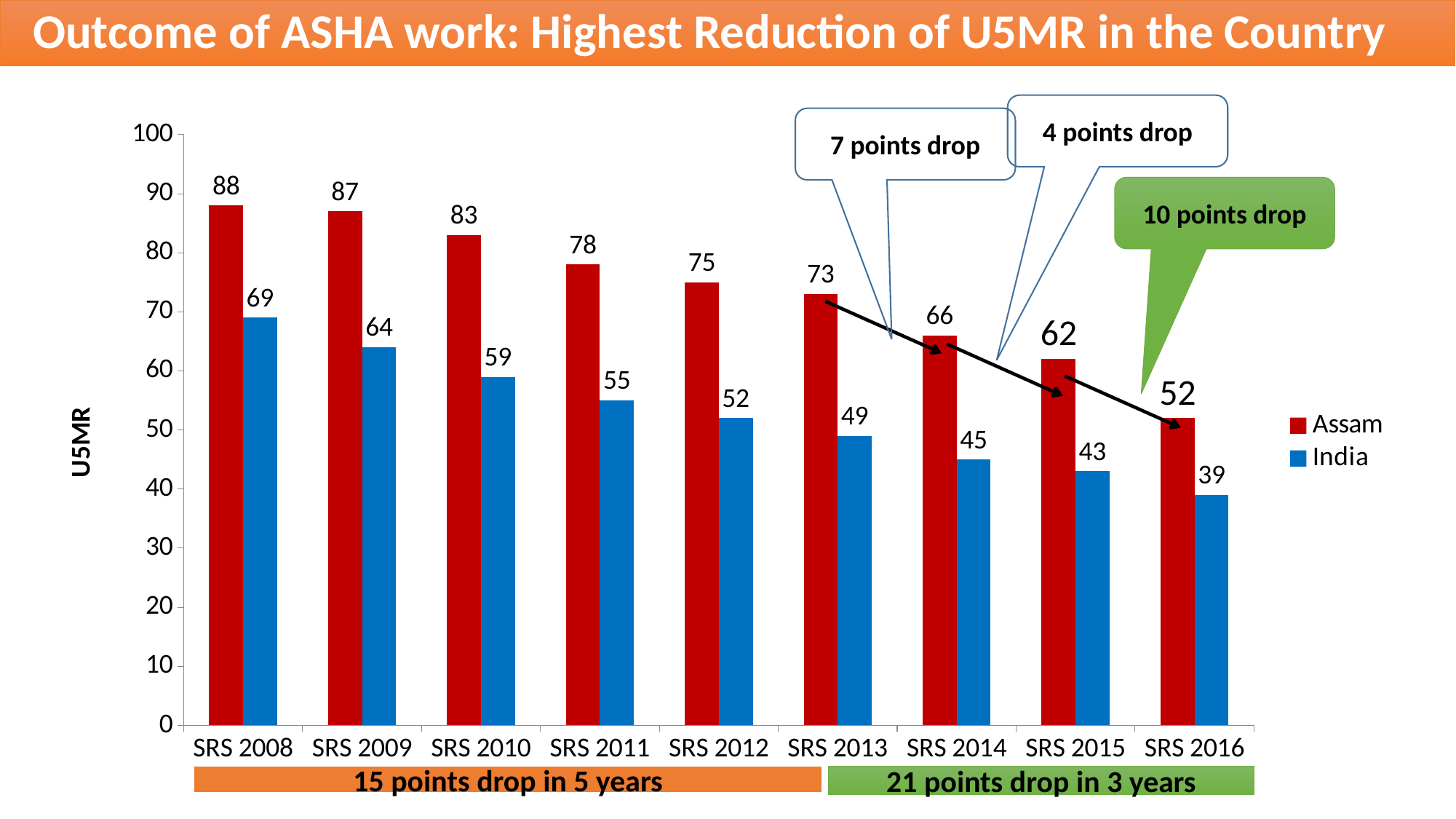
Do the Assam U5MR values rise or fall from SRS 2008 to SRS 2016? Fall What is the U5MR value for Assam in SRS 2008? 88 Which is larger, the Assam value in SRS 2016 or the India value in SRS 2012? They are equal (52) How many SRS years are shown on the x axis? 9 What is the U5MR value for India in SRS 2016? 39 What is the difference between Assam's U5MR in SRS 2015 and SRS 2016? 10 What is the U5MR value for Assam in SRS 2013? 73 What kind of chart is shown on the slide? Bar chart How many series does the legend list? 2 Which year has the highest U5MR value for India? SRS 2008 Which year has the lowest U5MR value for Assam? SRS 2016 What is the difference between the Assam and India U5MR values in SRS 2012? 23